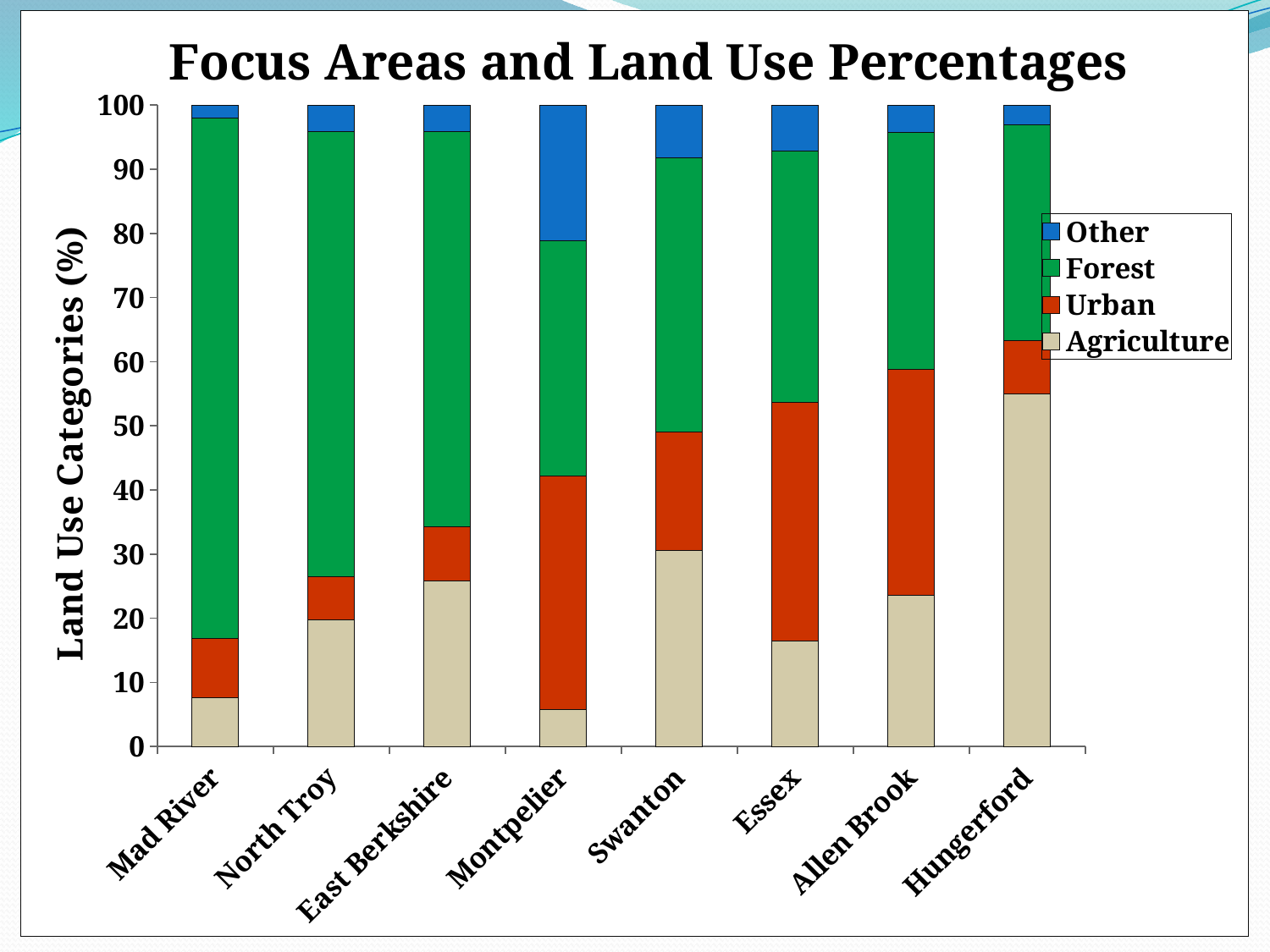
What kind of chart is shown on the slide? Stacked bar chart Is the Agriculture value for Mad River greater or less than 10? less How many focus areas are shown along the x axis? 8 Is the Agriculture value for Hungerford greater or less than 50? greater How many series does the legend list? 4 Which focus area has the largest Other segment? Montpelier Is the Agriculture value for East Berkshire greater or less than 20? greater What is the total of the stacked bar for Montpelier? 100 What is the title of the chart? Focus Areas and Land Use Percentages Which focus area has the largest Agriculture segment? Hungerford Which focus area has the largest Forest segment? Mad River Which has the larger Agriculture segment, Swanton or Essex? Swanton